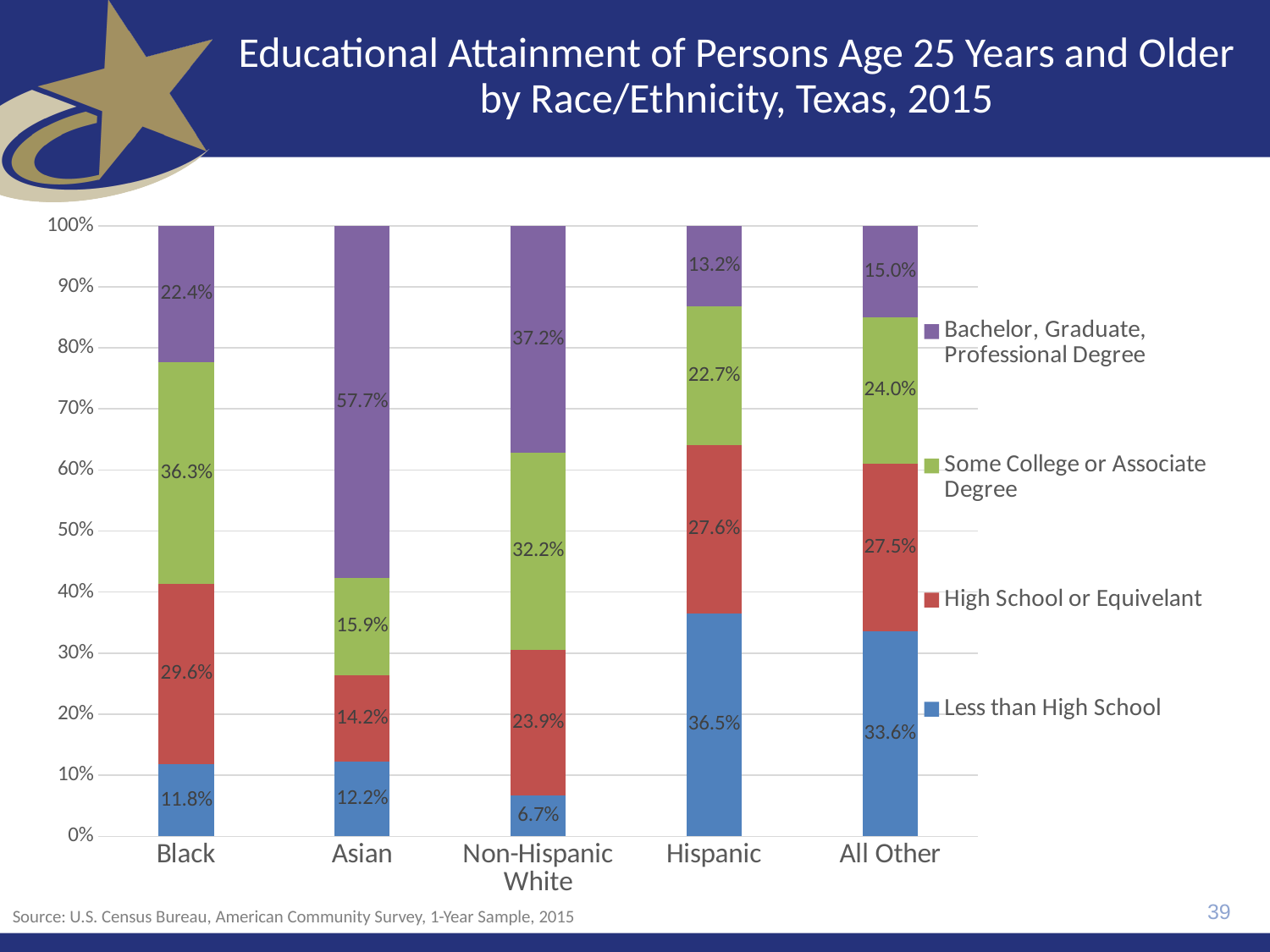
What is the Some College or Associate Degree percentage for Black persons? 36.3% What percentage of Asians age 25 and older have a Bachelor, Graduate, or Professional Degree? 57.7% What kind of chart is shown on the slide? Stacked bar chart Which is larger: the High School or Equivelant percentage for Black persons or for Asian persons? Black Which colour represents the Less than High School series in the legend? Blue What is the Less than High School percentage for Hispanic persons? 36.5% How many series does the legend list? 4 What is the difference between the Bachelor, Graduate, Professional Degree percentages for Non-Hispanic White and Hispanic persons? 24.0% Which race/ethnicity group has the highest Bachelor, Graduate, Professional Degree percentage? Asian How many race/ethnicity categories are shown on the x axis? 5 Which race/ethnicity group has the lowest Less than High School percentage? Non-Hispanic White What is the High School or Equivelant percentage for All Other persons? 27.5%